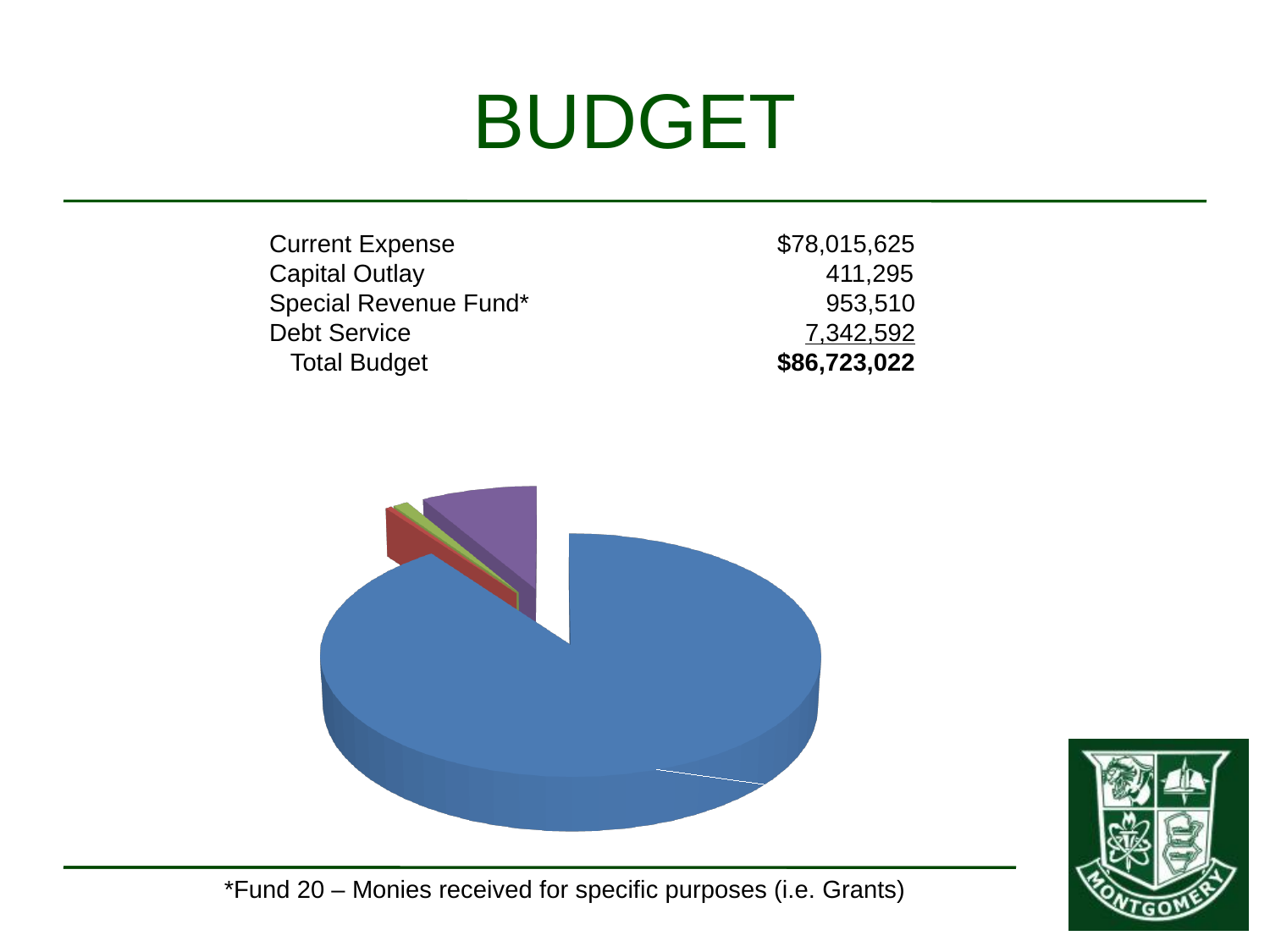
What is the Total Budget shown on the slide? $86,723,022 Is the blue slice of the pie chart greater or less than half of the pie? greater What kind of chart is shown on the slide? Pie chart Does the pie chart include a legend? No Which budget category listed on the slide has the largest value? Current Expense According to the budget figures on the slide, what is the value for Current Expense? $78,015,625 Which colour slice is the largest in the pie chart? Blue Does the pie chart display data labels on its slices? No Which budget category listed on the slide has the smallest value? Capital Outlay According to the budget figures on the slide, what is the value for Debt Service? 7,342,592 What is the difference between the Special Revenue Fund and Capital Outlay values shown on the slide? 542,215 How many slices does the pie chart have? 4